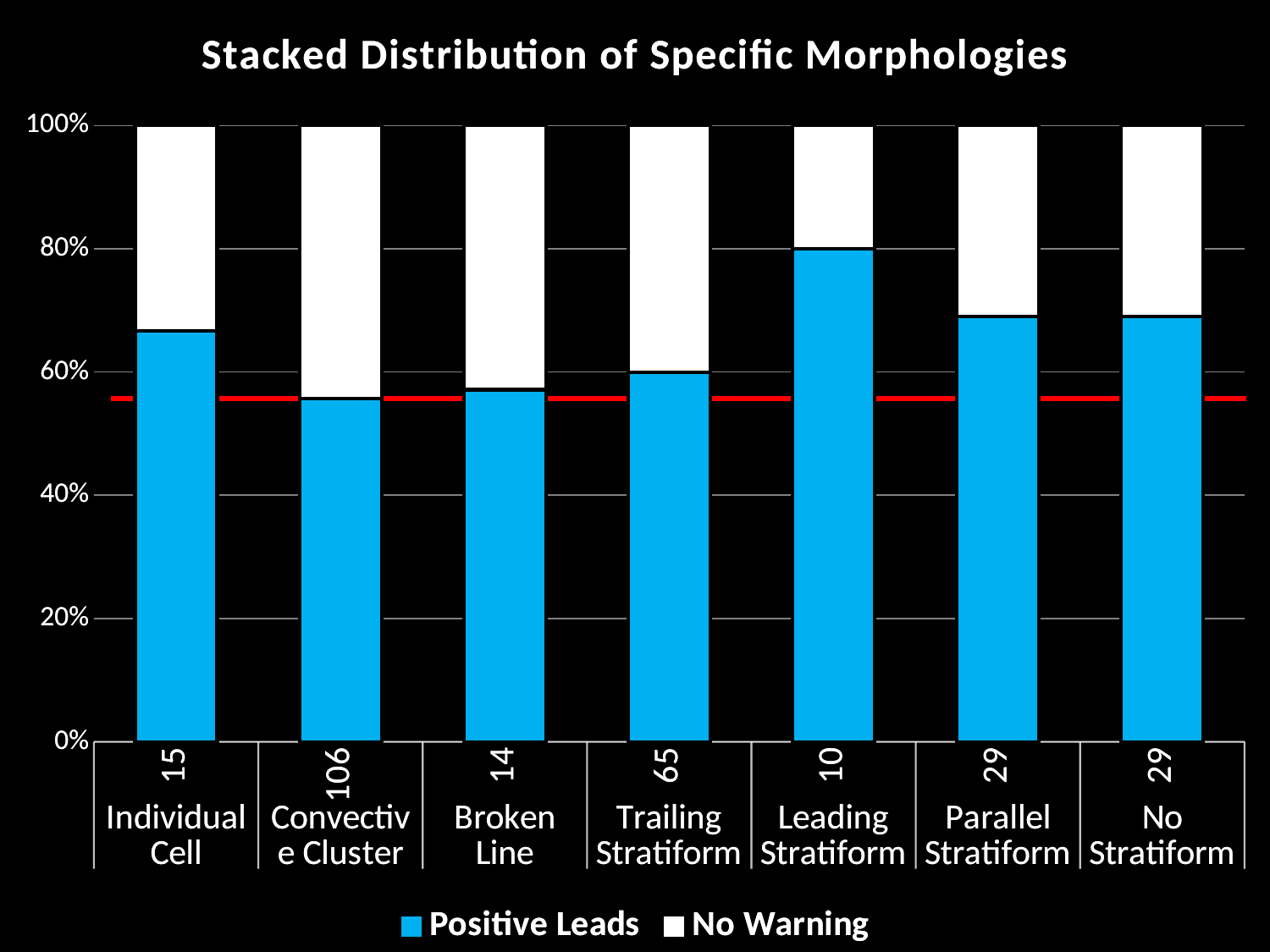
Which category has the largest number printed beneath its bar? Convective Cluster Is the Positive Leads value for Convective Cluster greater or less than 60%? less What number is printed beneath the Convective Cluster bar? 106 Which category has the highest Positive Leads percentage? Leading Stratiform What number is printed beneath the Leading Stratiform bar? 10 Which has a larger Positive Leads share, Individual Cell or Trailing Stratiform? Individual Cell What is the difference between the numbers printed beneath the Convective Cluster and Individual Cell bars? 91 What kind of chart is shown on the slide? Stacked bar chart How many series does the legend list? 2 What is the title of the chart? Stacked Distribution of Specific Morphologies What is the Positive Leads percentage for Leading Stratiform? 80% How many morphology categories are shown on the x axis? 7